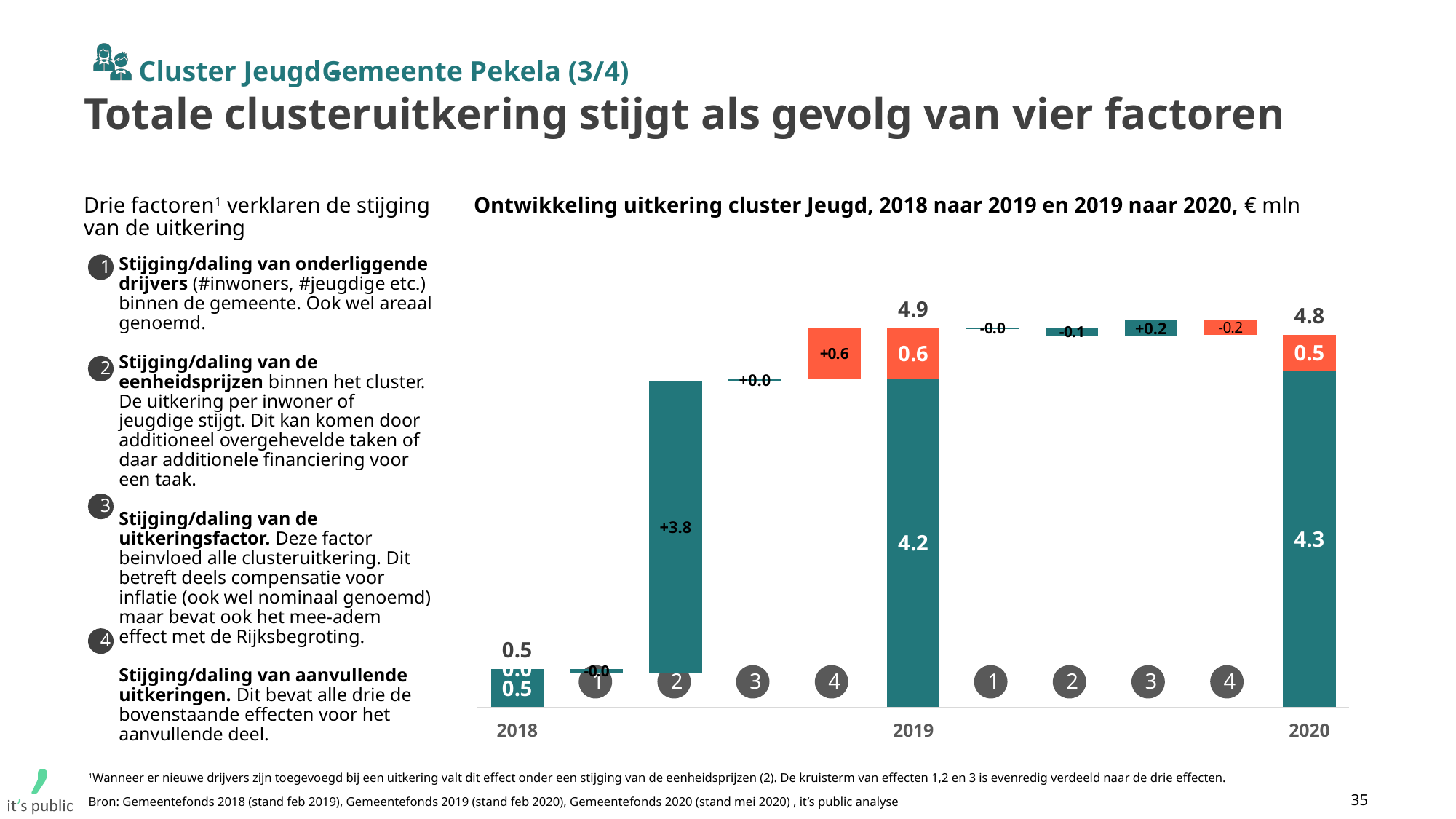
What is the value of the factor 2 step between 2018 and 2019? +3.8 Does the total uitkering rise or fall from 2019 to 2020? fall Which year has the highest total uitkering? 2019 What is the total uitkering shown for 2018? 0.5 What is the value of the factor 3 step between 2019 and 2020? +0.2 What is the value of the factor 4 step between 2018 and 2019? +0.6 What is the total uitkering shown for 2019? 4.9 What is the total uitkering shown for 2020? 4.8 What is the difference between the 2019 total and the 2018 total? 4.4 What is the value of the teal (lower) segment of the 2019 bar? 4.2 What is the value of the orange (upper) segment of the 2020 bar? 0.5 What kind of chart is shown on the slide? bar chart